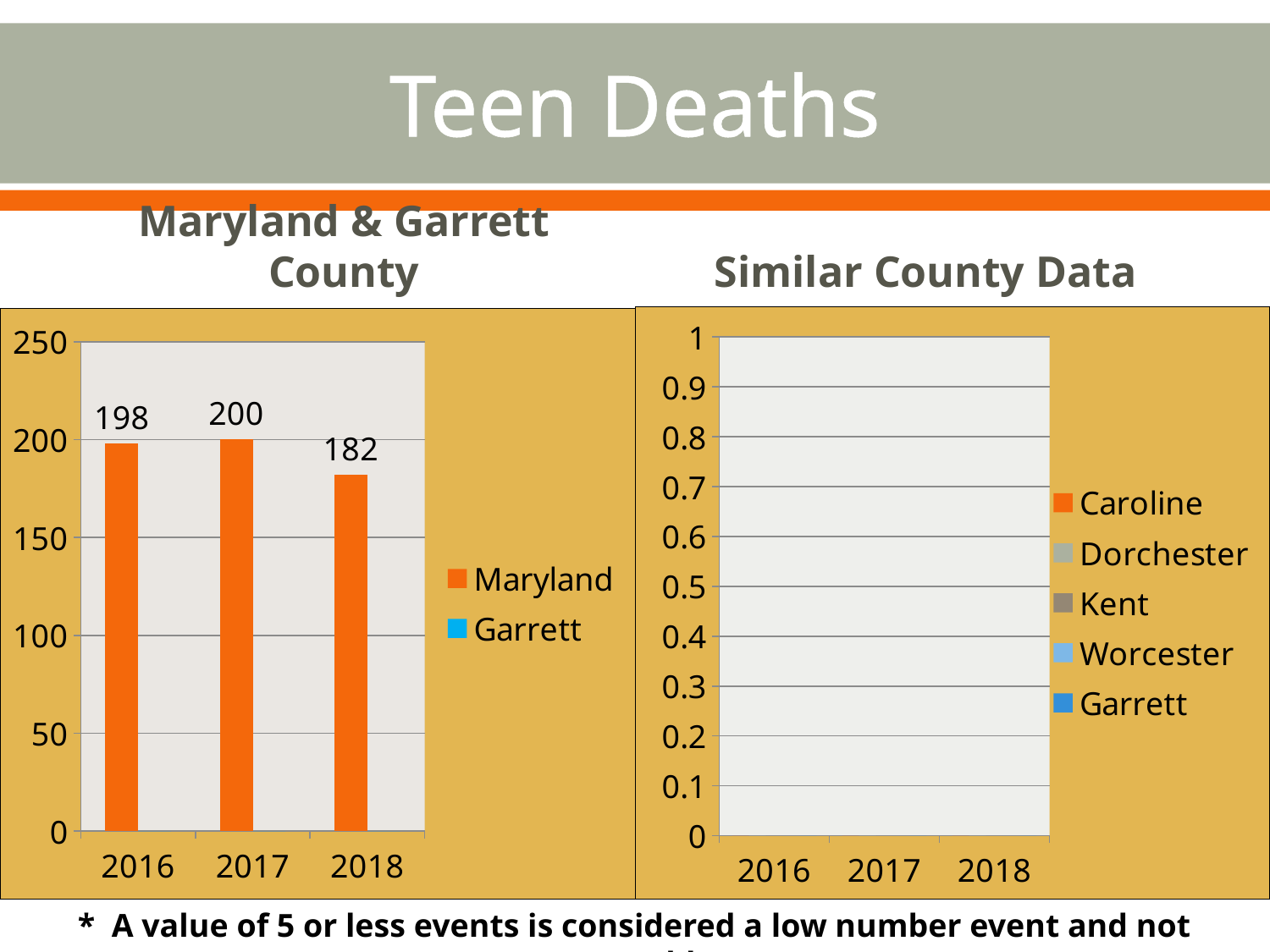
In the Maryland & Garrett County chart, is the Maryland value for 2016 or 2018 larger? 2016 What kind of chart is the Maryland & Garrett County chart? bar chart In the Maryland & Garrett County chart, is the Maryland value for 2018 greater or less than 200? less In the Maryland & Garrett County chart, which year has the lowest Maryland value? 2018 In the Maryland & Garrett County chart, which year has the highest Maryland value? 2017 How many series does the legend of the Maryland & Garrett County chart list? 2 In the Maryland & Garrett County chart, what is the value for Maryland in 2017? 200 In the Maryland & Garrett County chart, what is the value for Maryland in 2018? 182 In the Maryland & Garrett County chart, what is the value for Maryland in 2016? 198 In the Maryland & Garrett County chart, what is the difference between the Maryland values for 2017 and 2018? 18 How many series does the legend of the Similar County Data chart list? 5 How many years are shown on the x axis of the Maryland & Garrett County chart? 3